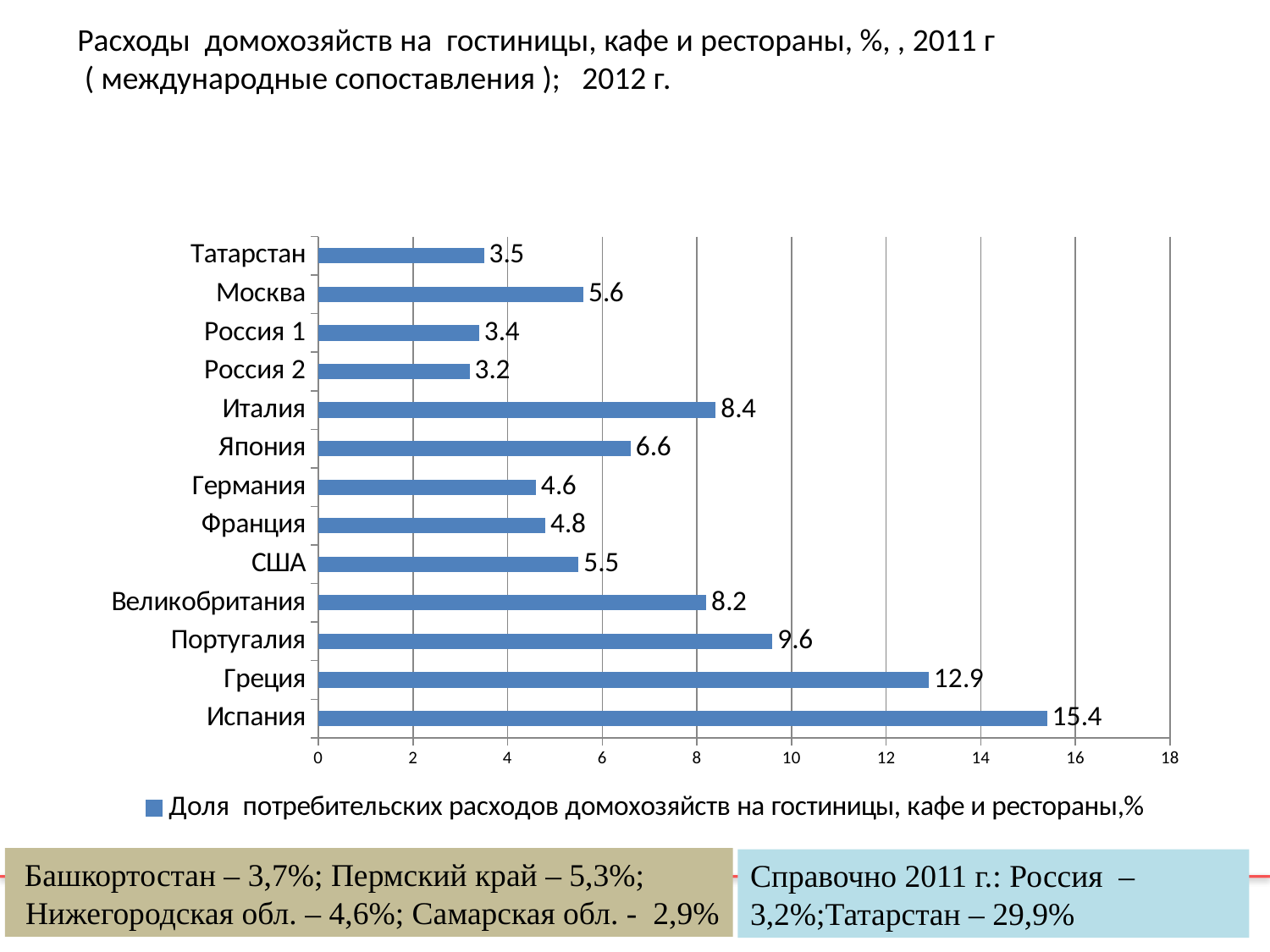
Which is larger, the value for Италия or the value for Великобритания? Италия What is the value for Татарстан? 3.5 Which category has the lowest value? Россия 2 What is the value for Япония? 6.6 Which is larger, the value for Москва or the value for США? Москва How many categories are shown on the chart? 13 What is the value for Испания? 15.4 What kind of chart is shown? Bar chart How many series does the legend list? 1 What is the legend entry for the series? Доля потребительских расходов домохозяйств на гостиницы, кафе и рестораны,% What is the difference between the values for Греция and Португалия? 3.3 Which category has the highest value? Испания